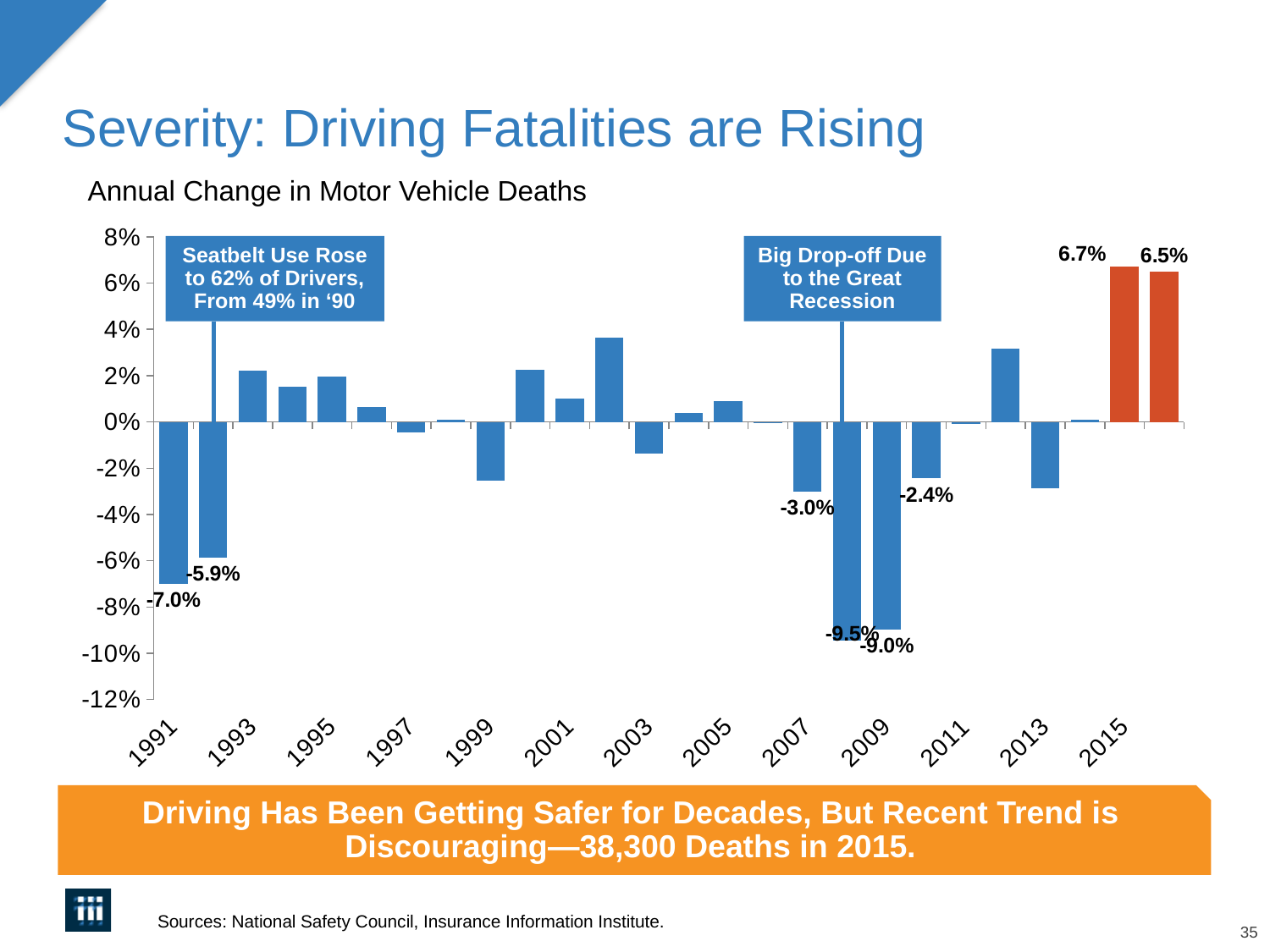
Between 1991 and 1993, do the values rise or fall? Rise What is the value shown for 2007? -3.0% What kind of chart is shown on the slide? Bar chart What is the difference between the values for 2007 and 2009? 6.0 percentage points What is the lowest value labeled on the chart? -9.5% What is the value shown for 1991? -7.0% What is the annual change in motor vehicle deaths shown for 2015? 6.7% What is the value shown for 2009? -9.0% What is the title of the chart? Annual Change in Motor Vehicle Deaths Is the value for 2013 greater or less than -2%? less Which year has the lower value, 1991 or 2007? 1991 Which year has the highest annual change in motor vehicle deaths? 2015